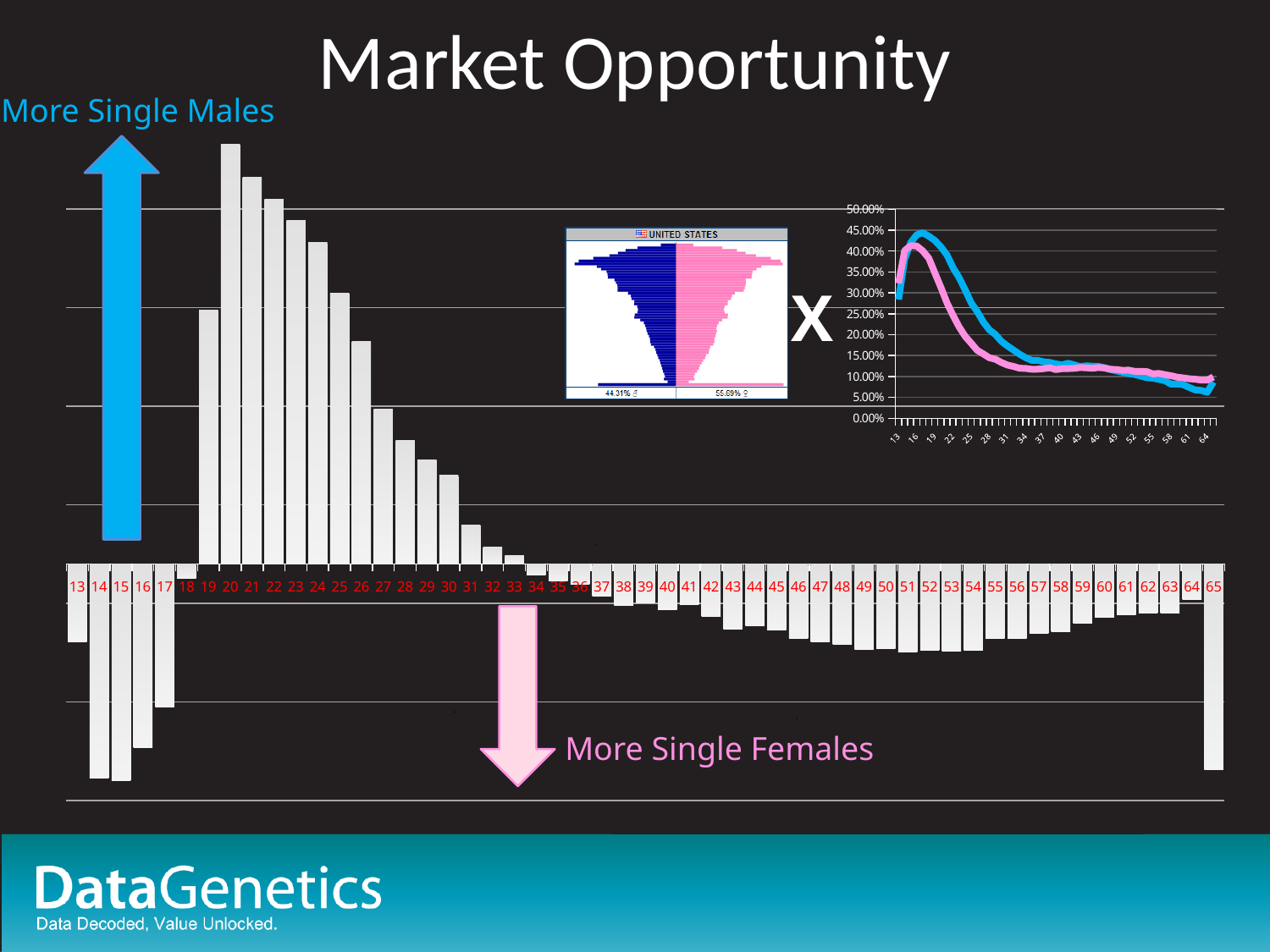
In the small line chart at the top right, how many lines are plotted? 2 In the large bar chart, is the bar for age 20 taller than the bar for age 30? Yes How many age categories are labelled along the axis of the large bar chart? 53 In the small line chart at the top right, which line is higher at age 16, the blue or the pink? blue In the United States population pyramid image, what percentage is shown for females? 55.69% In the United States population pyramid image, what percentage is shown for males? 44.31% In the large bar chart, do the bars rise or fall from age 20 to age 34? fall In the small line chart at the top right, do the lines rise or fall from age 19 to age 34? fall In the large bar chart, which age has the tallest bar above the axis? 20 What kind of chart is the large chart spanning the slide with ages 13 to 65? bar chart In the small line chart at the top right, is the value of the pink line at age 64 greater or less than 15.00%? less In the small line chart at the top right, is the peak value of the blue line greater or less than 40.00%? greater